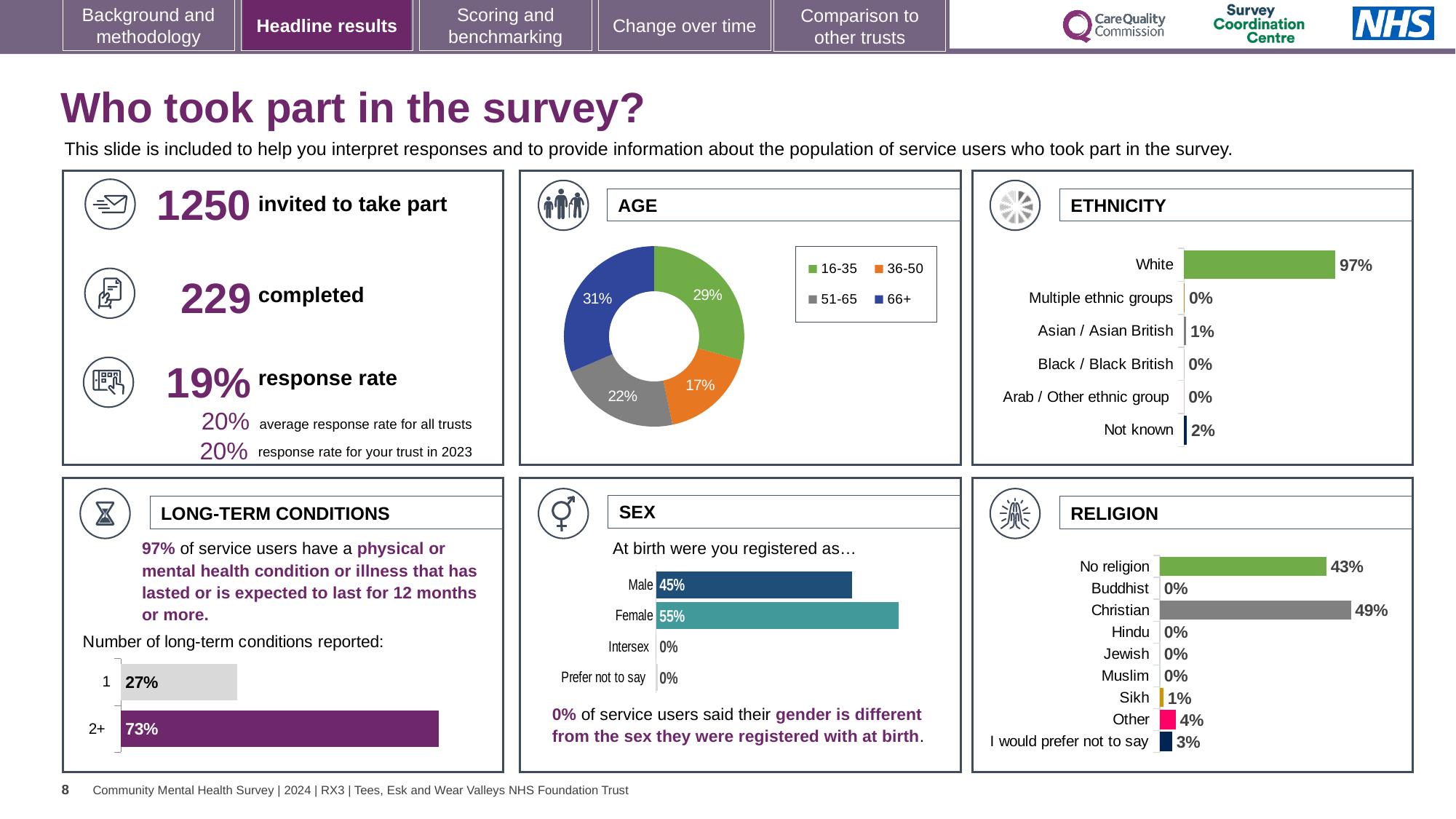
In the AGE chart, what share of respondents were aged 66+? 31% How many categories are shown in the ETHNICITY chart? 6 How many entries does the legend of the AGE chart list? 4 In the ETHNICITY chart, what is the value for White? 97% In the RELIGION chart, which category has the highest value? Christian In the SEX chart, what is the value for Male? 45% In the LONG-TERM CONDITIONS chart, what is the difference between the values for 2+ and 1? 46% What kind of chart is the AGE chart? Donut (pie) chart In the ETHNICITY chart, what is the value for Not known? 2% In the AGE chart, which age group has the smallest share? 36-50 In the RELIGION chart, what is the difference between Christian and No religion? 6% In the SEX chart, which is larger, Male or Female? Female